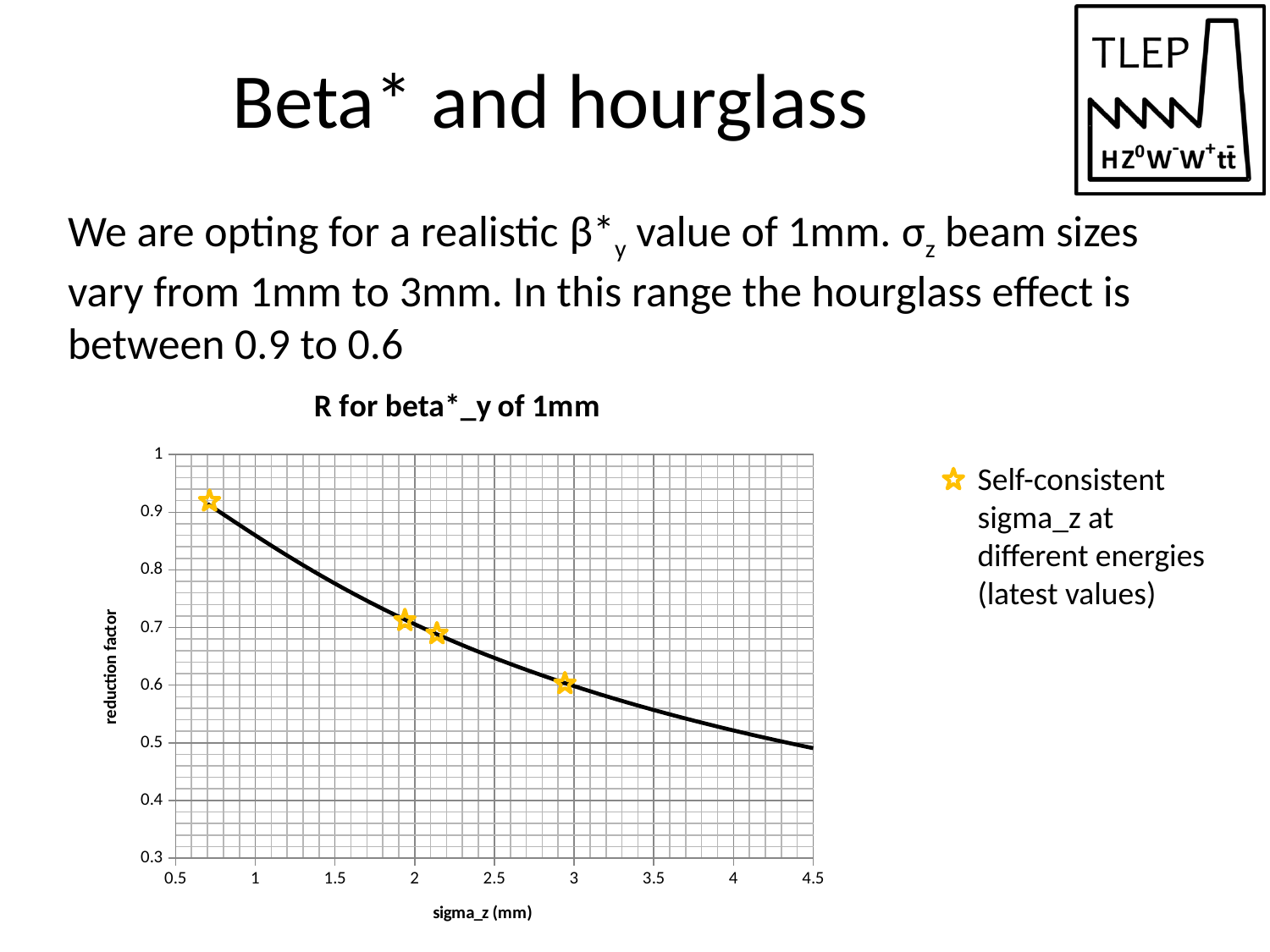
What kind of chart is shown on the slide? line chart What is the title of the chart? R for beta*_y of 1mm Is the reduction factor at sigma_z = 2.5 mm greater or less than 0.7? less Is the reduction factor at sigma_z = 1 mm greater or less than 0.8? greater Is the reduction factor at sigma_z = 4 mm greater or less than 0.5? greater Does the reduction factor rise or fall as sigma_z increases along the x axis? fall What is the label of the x axis of the chart? sigma_z (mm) Which has the larger reduction factor, sigma_z = 1 mm or sigma_z = 3 mm? sigma_z = 1 mm How many star markers are plotted on the curve? 4